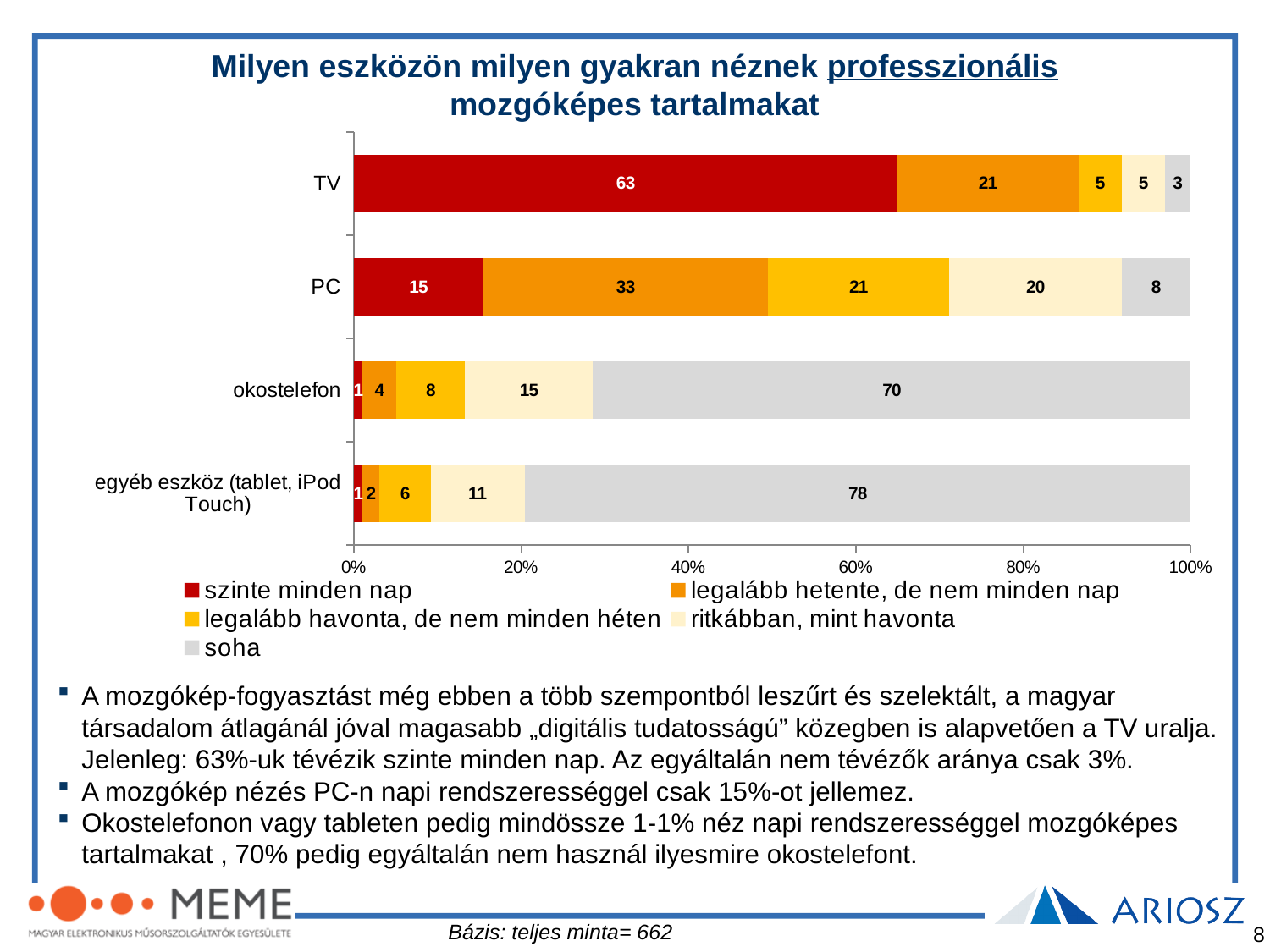
What is the total of the labelled segments in the PC bar? 97 What is the value of "soha" for okostelefon? 70 Which device has the highest value for "szinte minden nap"? TV Which is larger: the "legalább havonta, de nem minden héten" value for PC or for okostelefon? PC How many series does the legend list? 5 What is the value of "legalább hetente, de nem minden nap" for PC? 33 How many device categories are plotted on the chart? 4 What is the difference between the "soha" values for egyéb eszköz (tablet, iPod Touch) and okostelefon? 8 What is the value of "ritkábban, mint havonta" for egyéb eszköz (tablet, iPod Touch)? 11 Which device has the lowest value for "soha"? TV What is the value of "szinte minden nap" for TV? 63 What kind of chart is shown on the slide? stacked bar chart